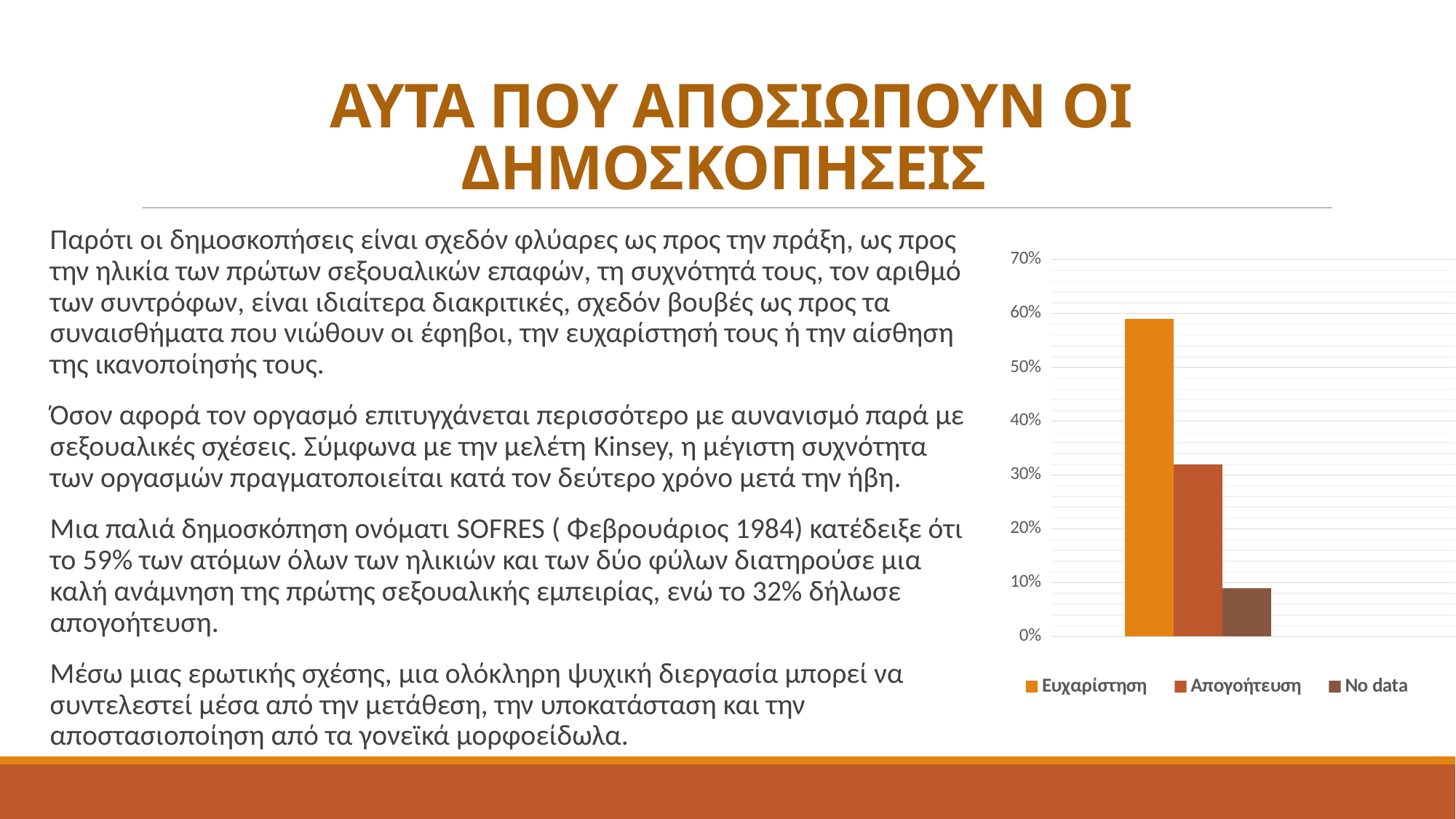
Which is larger in the chart, Απογοήτευση or No data? Απογοήτευση How many bars are plotted in the chart? 3 What is the highest value shown on the chart's vertical axis? 70% Which series has the highest value in the chart? Ευχαρίστηση What colour is the bar for Ευχαρίστηση in the chart? orange Which is larger in the chart, Ευχαρίστηση or Απογοήτευση? Ευχαρίστηση How many series does the chart's legend list? 3 Is the value for No data greater or less than 20%? less Which series has the lowest value in the chart? No data What kind of chart is shown on the slide? bar chart Is the value for Απογοήτευση greater or less than 40%? less Is the value for Ευχαρίστηση greater or less than 50%? greater